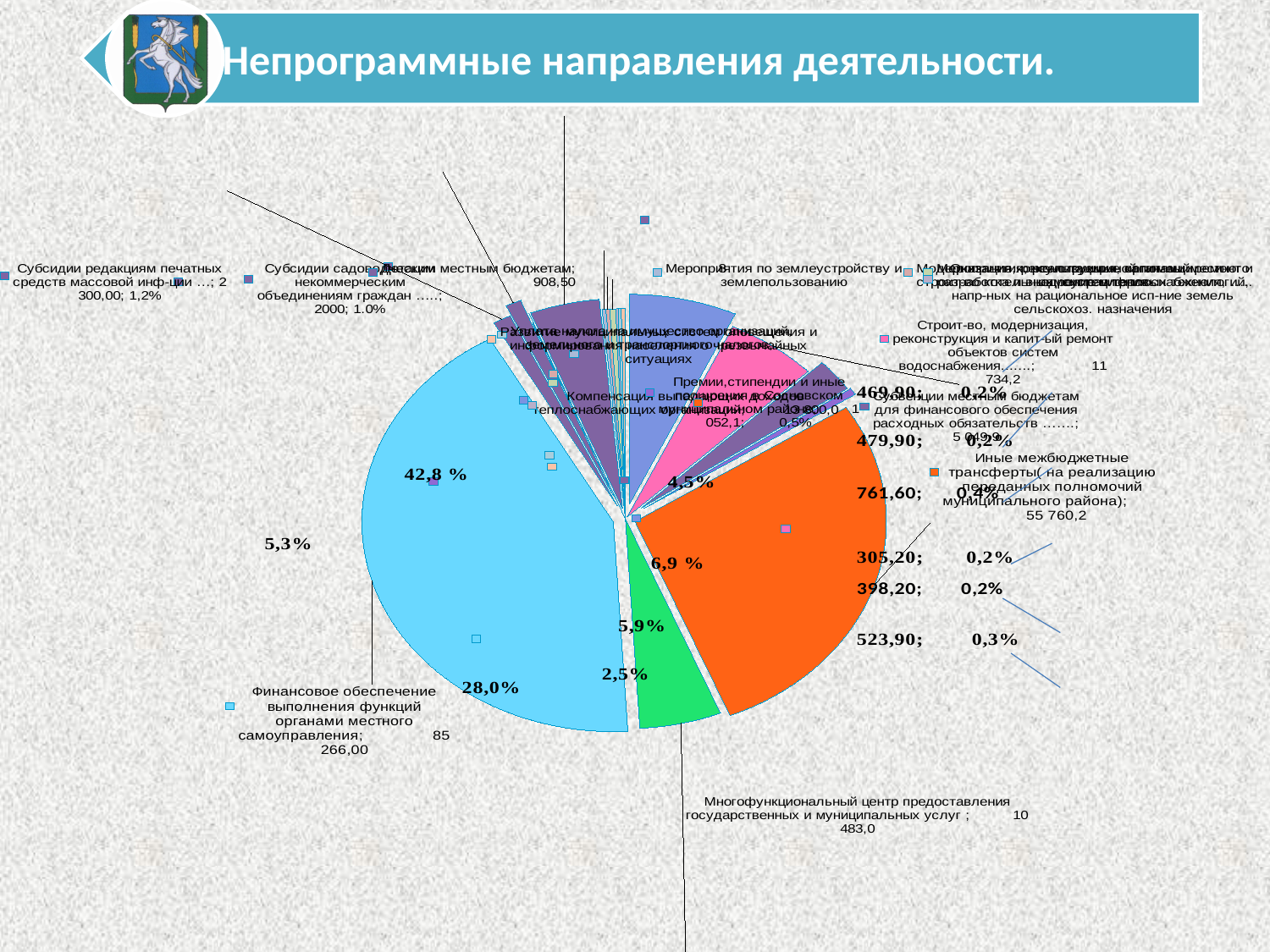
What kind of chart is shown on the slide? pie chart What is the title of the slide containing the chart? Непрограммные направления деятельности. What value is shown for "Дотации местным бюджетам"? 8 908,50 What share of the pie does "Субсидии садоводческим некоммерческим объединениям граждан" represent? 1.0% Which is larger: "Финансовое обеспечение выполнения функций органами местного самоуправления" or "Иные межбюджетные трансферты"? Финансовое обеспечение выполнения функций органами местного самоуправления What value is shown for "Строит-во, модернизация, реконструкция и капит-ый ремонт объектов систем водоснабжения"? 11 734,2 What value is shown for "Субсидии редакциям печатных средств массовой инф-ции"? 2 300,00 Which category has the largest slice of the pie? Финансовое обеспечение выполнения функций органами местного самоуправления What value is shown for "Иные межбюджетные трансферты (на реализацию переданных полномочий муниципального района)"? 55 760,2 What value is shown for "Многофункциональный центр предоставления государственных и муниципальных услуг"? 10 483,0 What value is shown for "Финансовое обеспечение выполнения функций органами местного самоуправления"? 85 266,00 What share of the pie does "Субсидии редакциям печатных средств массовой инф-ции" represent? 1,2%